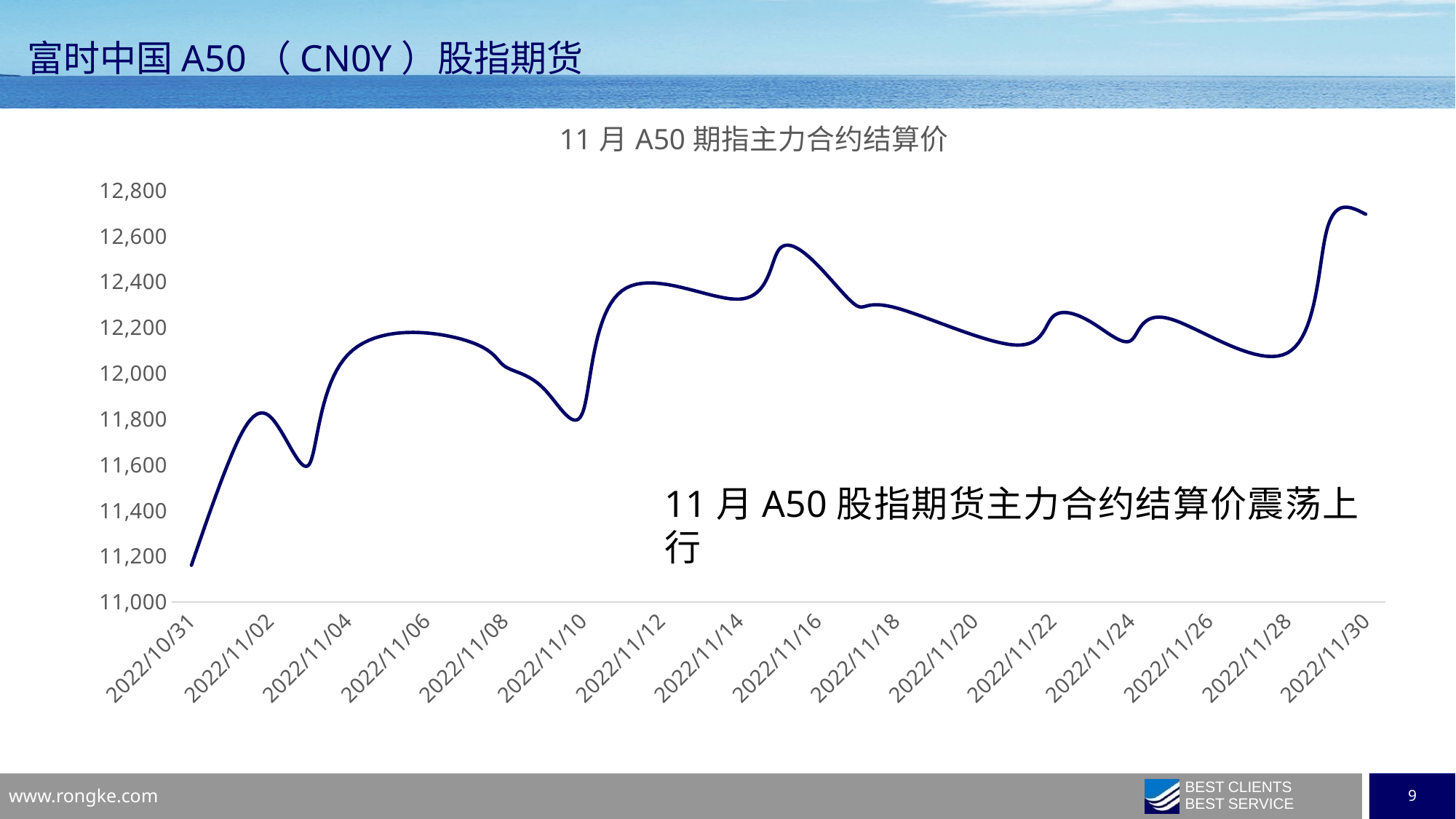
Which date has the lowest value on the chart? 2022/10/31 What kind of chart is shown on the slide? line chart Which is larger, the value for 2022/11/16 or the value for 2022/11/20? 2022/11/16 What is the title of the chart? 11 月 A50 期指主力合约结算价 Is the value for 2022/11/20 greater or less than 12,400? less Is the value for 2022/10/31 greater or less than 11,200? less Is the value for 2022/11/28 greater or less than 12,200? less Overall, do the values rise or fall from 2022/10/31 to 2022/11/30? rise How many date labels are shown on the x axis? 16 Which is larger, the value for 2022/11/30 or the value for 2022/10/31? 2022/11/30